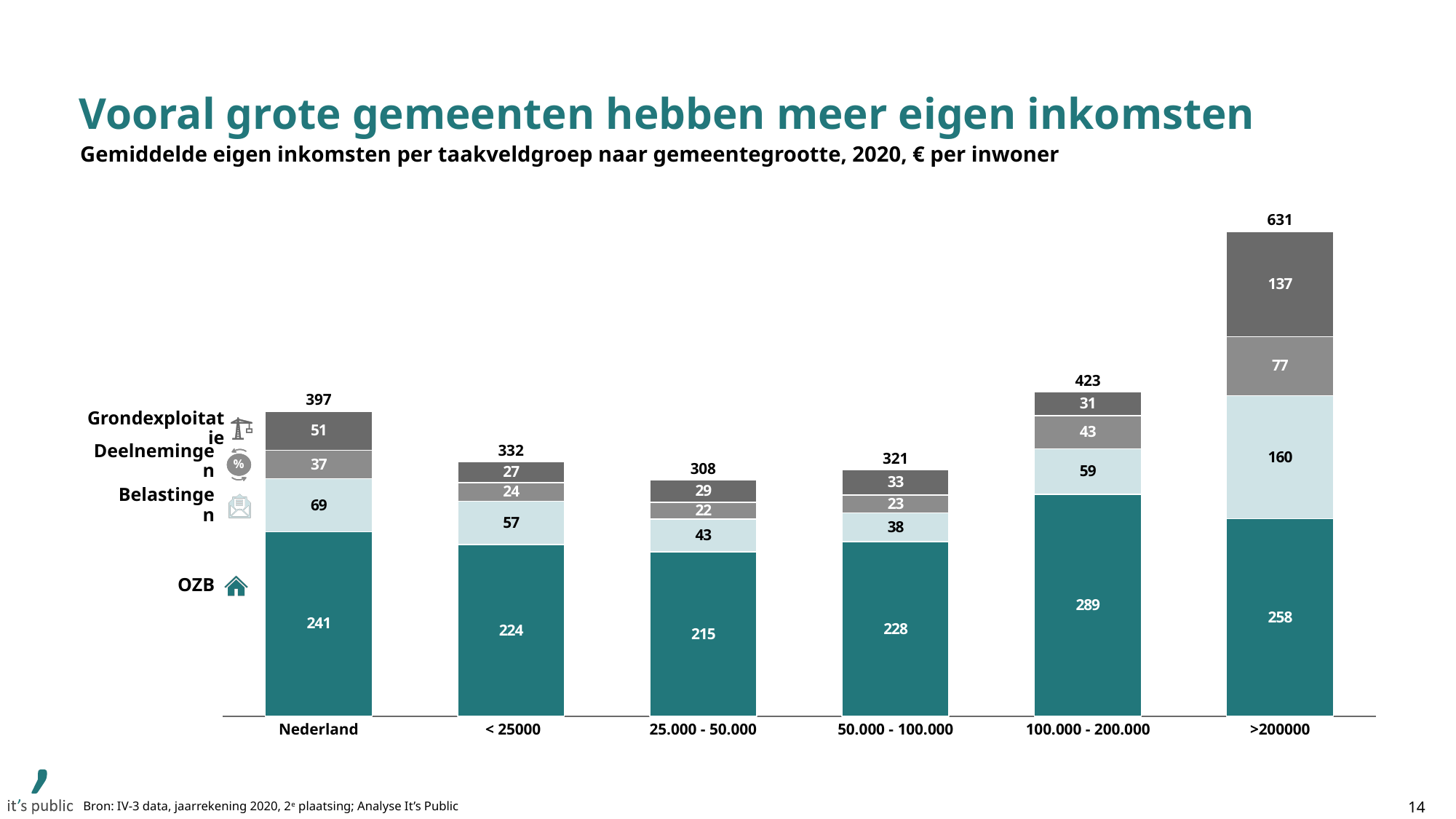
What is the Deelnemingen value for the 25.000 - 50.000 category? 22 Which category has the highest total? >200000 Which category has the lowest total? 25.000 - 50.000 Which is larger: the OZB value for < 25000 or the OZB value for 50.000 - 100.000? 50.000 - 100.000 What kind of chart is shown on the slide? Stacked bar chart How many series does the legend list? 4 What is the difference between the total for >200000 and the total for Nederland? 234 What is the OZB value for the >200000 category? 258 What is the total for the 100.000 - 200.000 category? 423 What is the Belastingen value for the 100.000 - 200.000 category? 59 What is the Grondexploitatie value for Nederland? 51 How many categories are shown on the x axis? 6